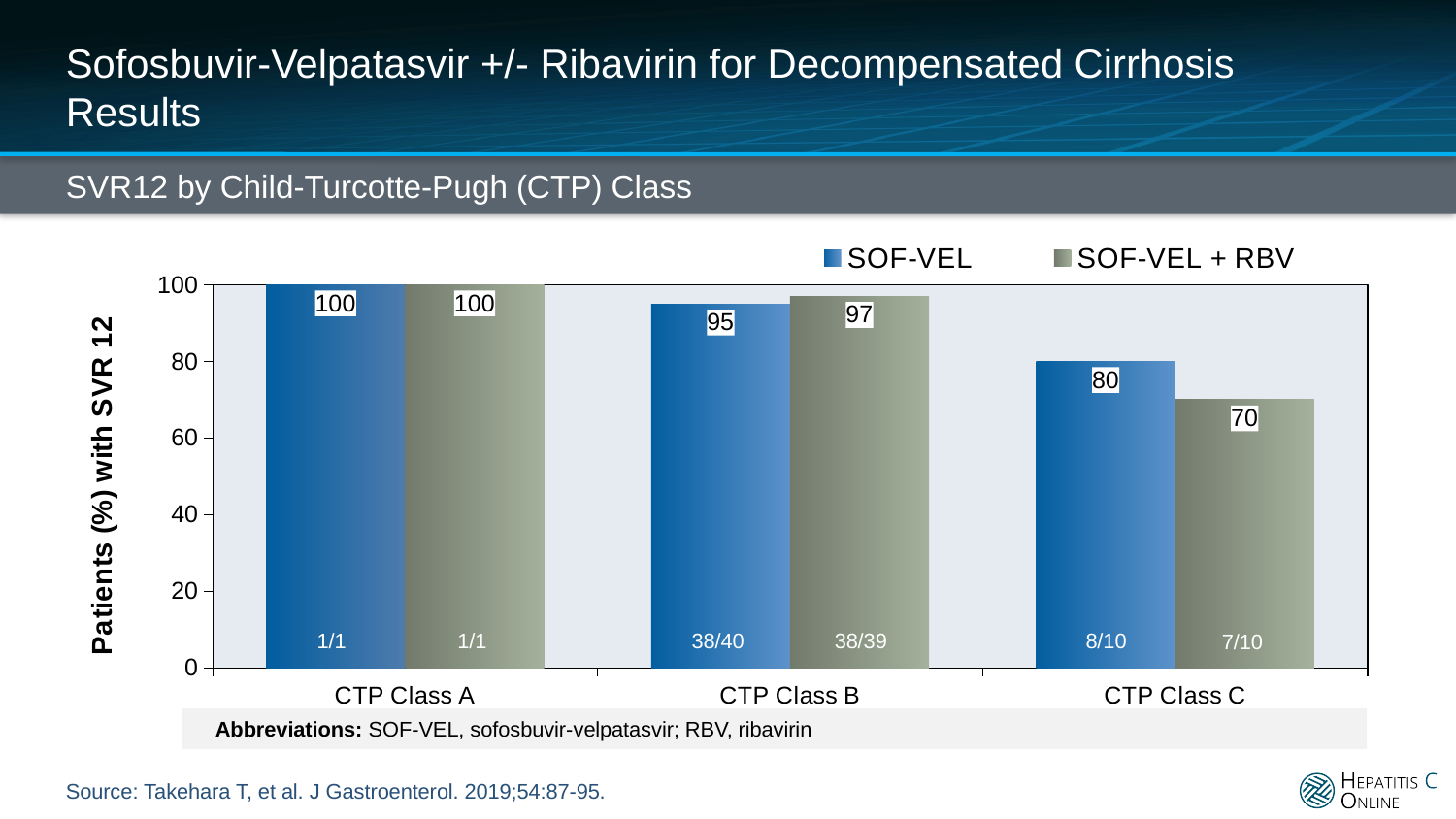
Do the SOF-VEL values rise or fall from CTP Class A to CTP Class C? Fall What kind of chart is shown on the slide? Bar chart What is the SVR12 value for SOF-VEL in CTP Class B? 95 In CTP Class B, which is larger: the SOF-VEL value or the SOF-VEL + RBV value? SOF-VEL + RBV How many series does the legend list? 2 What is the SVR12 value for SOF-VEL in CTP Class C? 80 What is the label of the y axis? Patients (%) with SVR 12 What is the difference between the SOF-VEL and SOF-VEL + RBV values in CTP Class C? 10 What fraction of patients is shown inside the SOF-VEL + RBV bar for CTP Class B? 38/39 What is the SVR12 value for SOF-VEL + RBV in CTP Class C? 70 Which CTP class has the lowest SVR12 value for SOF-VEL + RBV? CTP Class C How many CTP classes are shown on the x axis? 3